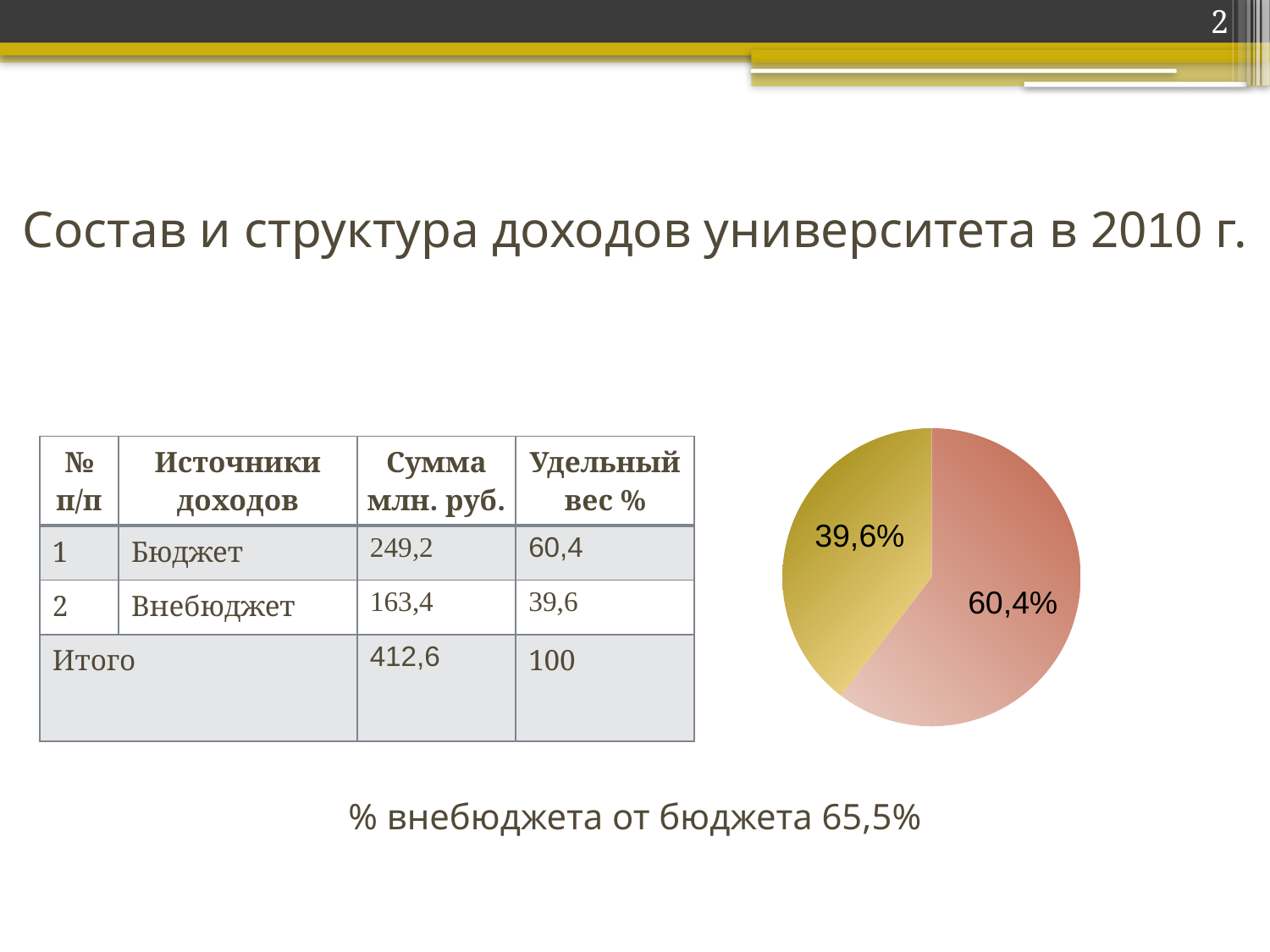
According to the table next to the pie chart, which income source does the 60,4% slice correspond to? Бюджет What is the share shown on the larger (pink) slice of the pie chart? 60,4% Is the share of the pink slice in the pie chart greater or less than 50%? greater What colour is the slice labelled 39,6% in the pie chart? yellow How many slices does the pie chart have? 2 According to the table next to the pie chart, which income source does the 39,6% slice correspond to? Внебюджет Which slice of the pie chart is the smallest, the pink one or the yellow one? the yellow one Is the share of the yellow slice in the pie chart greater or less than 50%? less What is the difference in percentage points between the two slices of the pie chart? 20,8 What is the share shown on the smaller (yellow) slice of the pie chart? 39,6% Which slice of the pie chart is the largest, the pink one or the yellow one? the pink one What kind of chart is shown on the right side of the slide? pie chart